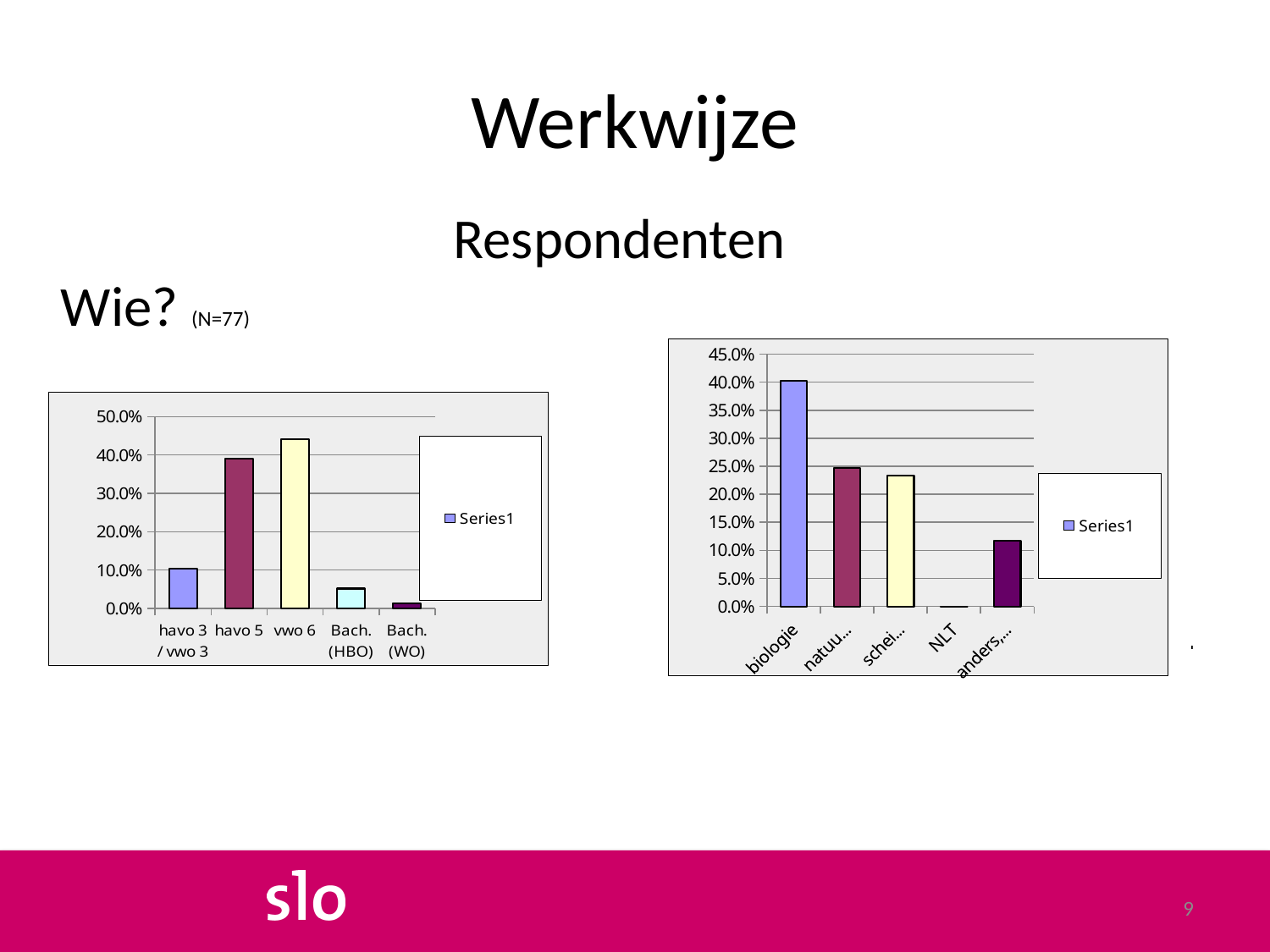
On the right chart, which category has the lowest value? NLT On the left chart, which is larger: havo 5 or Bach. (HBO)? havo 5 How many series does the legend of the right chart list? 1 On the left chart, which category has the highest value? vwo 6 What kind of chart is the left chart? bar chart On the right chart, which category has the highest value? biologie How many categories are shown on the left chart? 5 On the left chart, which category has the lowest value? Bach. (WO) On the right chart, is the value for biologie greater or less than 35.0%? greater On the left chart, is the value for havo 5 greater or less than 30.0%? greater On the left chart, is the value for havo 3 / vwo 3 greater or less than 20.0%? less